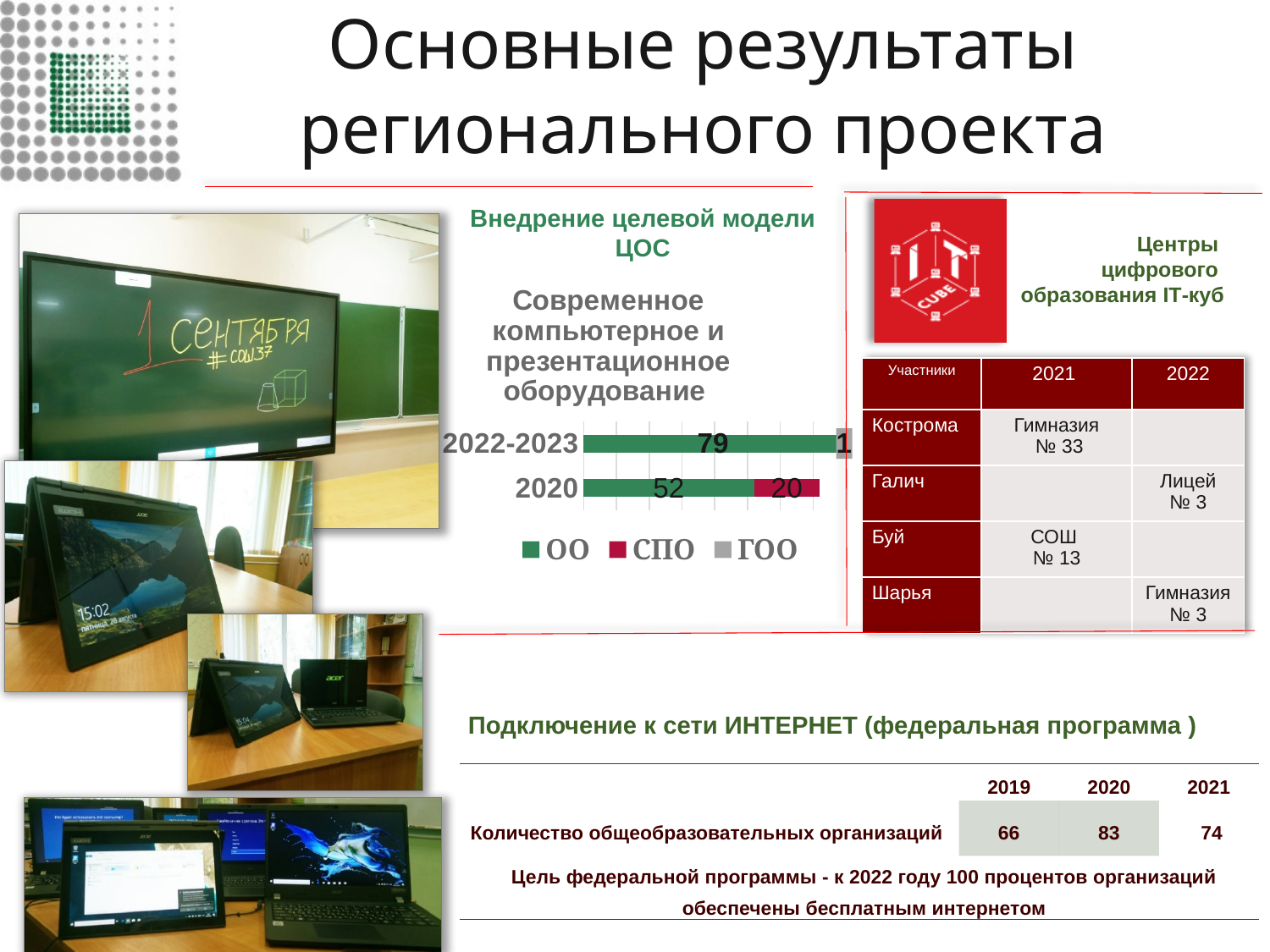
In the bar chart, which series has the highest value for 2020? ОО By how much does the ОО value for 2022-2023 exceed the ОО value for 2020 in the bar chart? 27 In the bar chart, what is the difference between the ОО and СПО values for 2020? 32 What is the value of the ОО series for 2020 in the bar chart? 52 What kind of chart is shown under the heading "Современное компьютерное и презентационное оборудование"? bar chart In the bar chart, which period has the larger ОО value, 2022-2023 or 2020? 2022-2023 What colour represents the ОО series in the bar chart? green How many categories (time periods) are shown on the bar chart? 2 What are the legend entries of the bar chart? ОО, СПО, ГОО What is the value of the СПО series for 2020 in the bar chart? 20 How many series does the legend of the bar chart list? 3 What is the value of the ОО series for 2022-2023 in the bar chart? 79